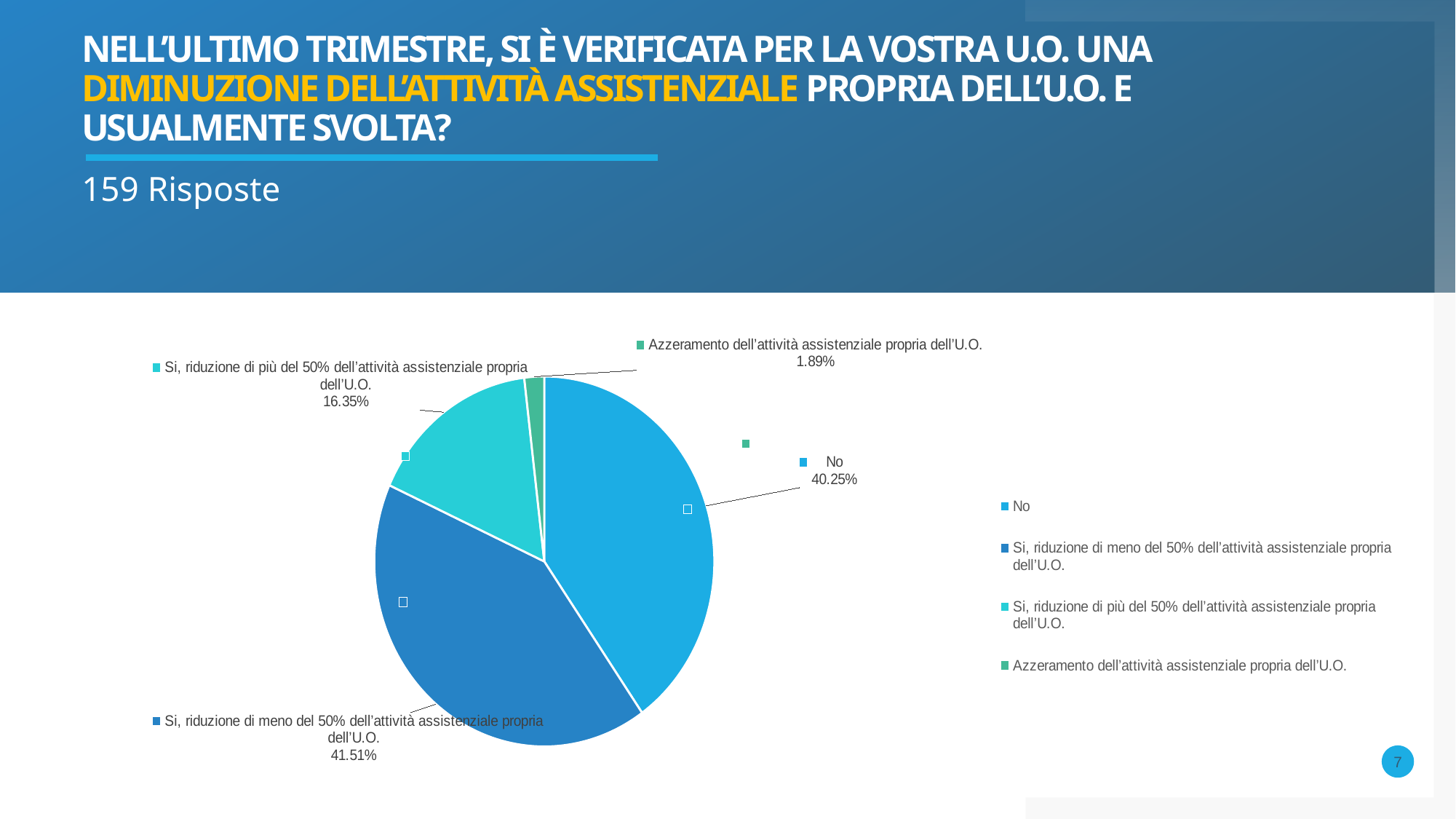
Which category has the largest slice of the pie? Si, riduzione di meno del 50% dell'attività assistenziale propria dell'U.O. What share of the pie does "Azzeramento dell'attività assistenziale propria dell'U.O." represent? 1.89% What colour is the "No" slice in the pie chart? light blue Which category has the smallest slice of the pie? Azzeramento dell'attività assistenziale propria dell'U.O. What is the difference in percentage points between the "No" slice and the "Si, riduzione di più del 50%" slice? 23.90% How many categories are shown in the pie chart? 4 What kind of chart is shown on the slide? pie chart What share of the pie does the "No" slice represent? 40.25% What share of the pie does "Si, riduzione di meno del 50% dell'attività assistenziale propria dell'U.O." represent? 41.51% How many responses does the slide say the chart is based on? 159 Which is larger: the "No" slice or the "Si, riduzione di più del 50% dell'attività assistenziale propria dell'U.O." slice? No